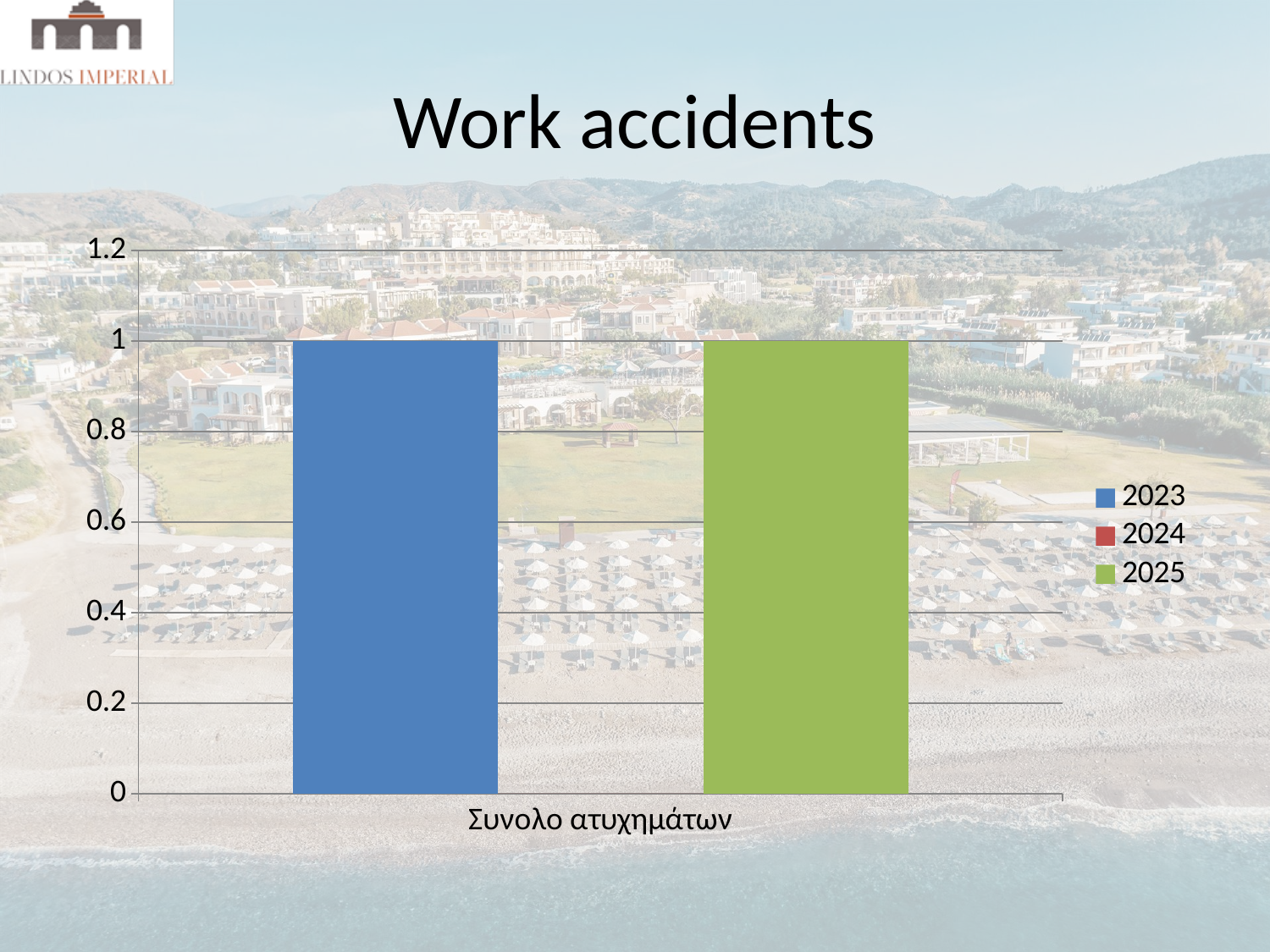
Is the value for 2025 greater or less than 1.2? less How many series does the legend list? 3 Is the value for 2023 greater or less than 0.8? greater What kind of chart is shown on the slide? bar chart What is the title of the chart? Work accidents What is the value for 2025 in the Σύνολο ατυχημάτων category? 1 Which series in the legend has no visible bar in the chart? 2024 How many categories are shown on the x axis? 1 What is the value for 2023 in the Σύνολο ατυχημάτων category? 1